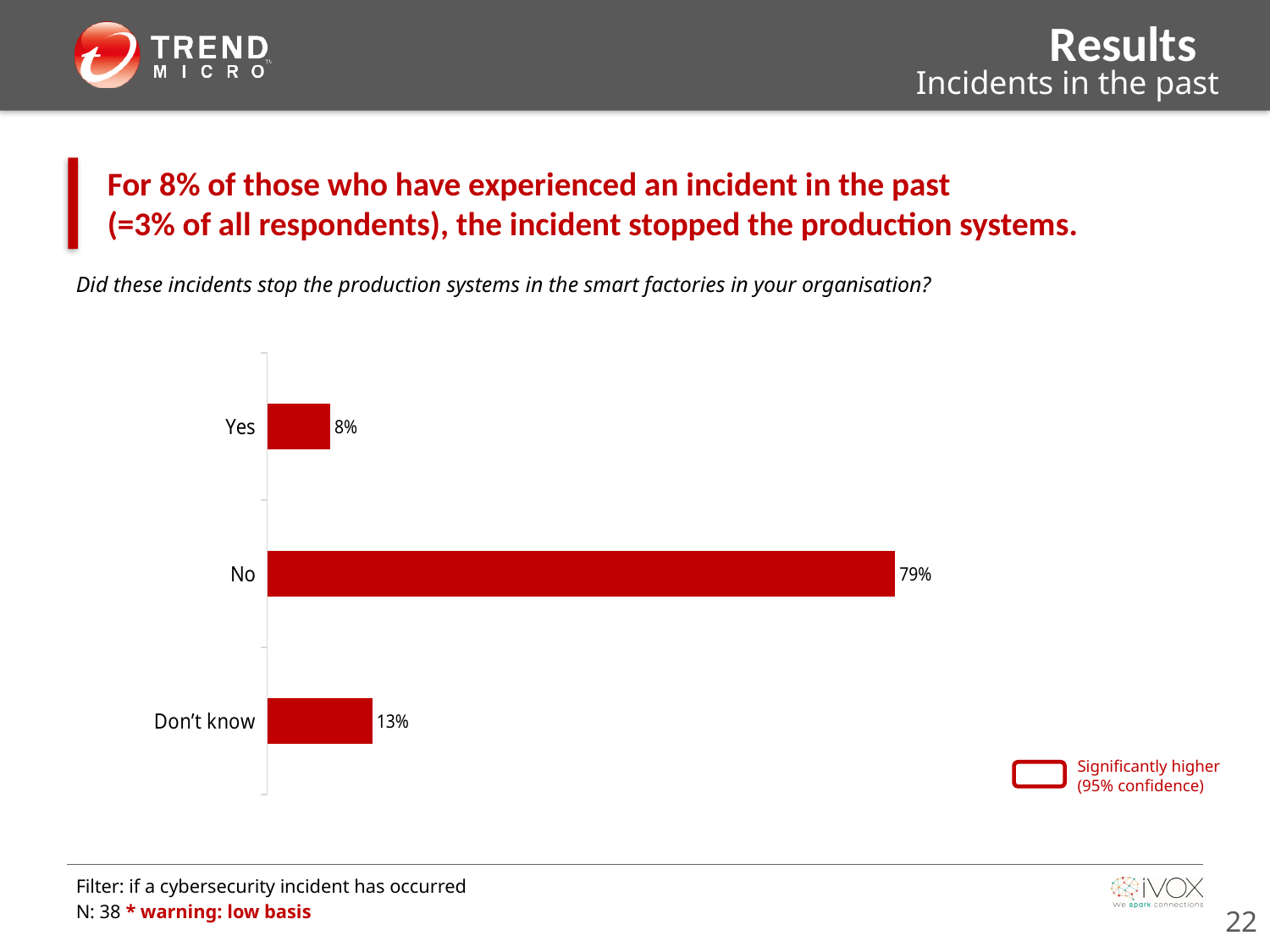
Which is larger, the value for "Don't know" or the value for "Yes"? Don't know What is the difference between the "Don't know" and "Yes" percentages? 5% How many response categories are shown in the chart? 3 What is the sample size (N) stated for this chart? 38 What question does the chart report responses to? Did these incidents stop the production systems in the smart factories in your organisation? What kind of chart is shown on the slide? Bar chart What percentage of respondents answered "Don't know"? 13% Which response category has the highest value? No What is the difference between the "No" and "Yes" percentages? 71% Which response category has the lowest value? Yes What percentage of respondents answered "No"? 79% What percentage of respondents answered "Yes"? 8%